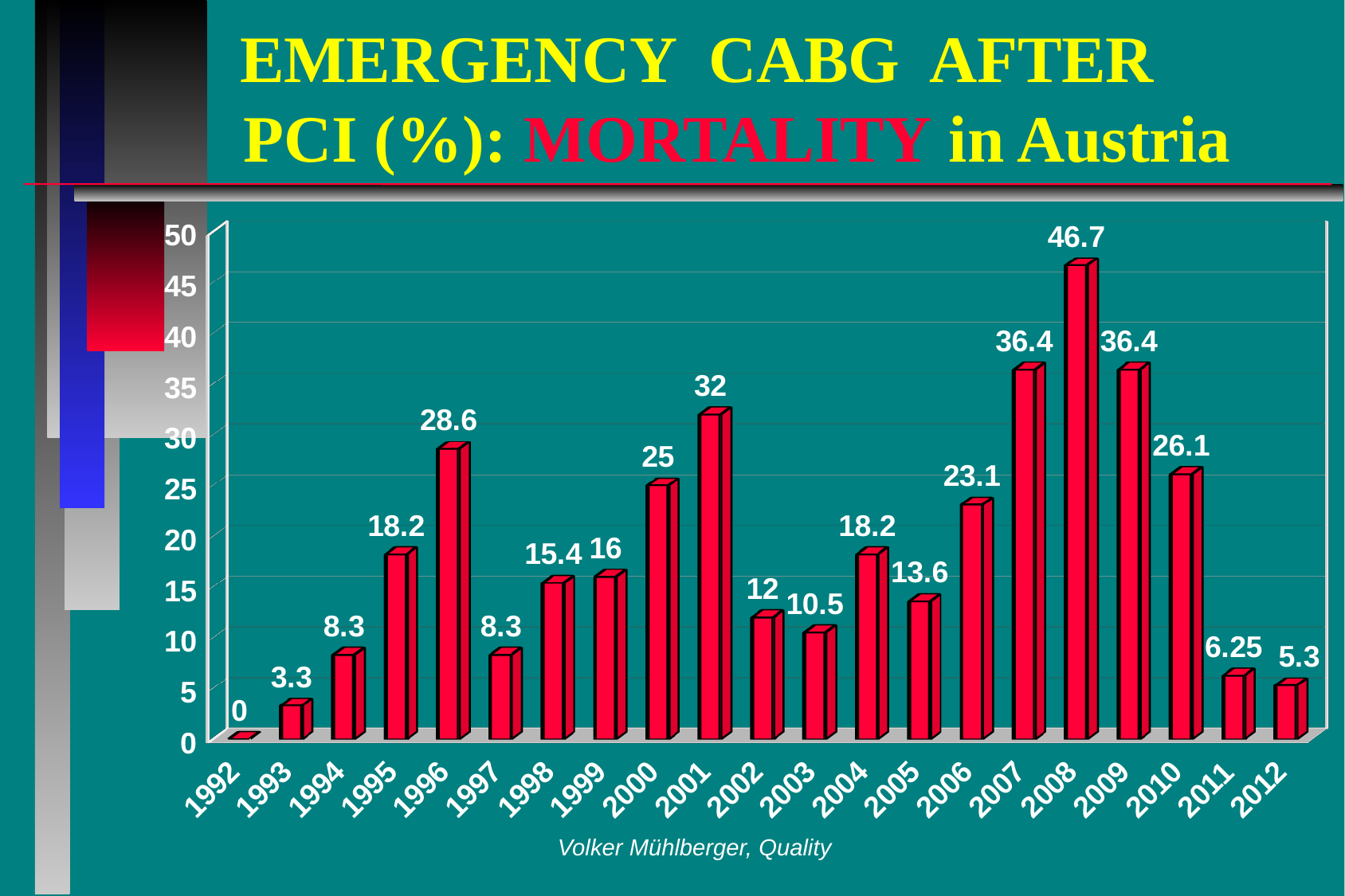
Do the values rise or fall from 2008 to 2012? fall Which is larger, the value for 1995 or the value for 2005? 1995 How many years are shown on the x axis? 21 What is the mortality value for 2011? 6.25 Which is larger, the value for 2000 or the value for 2010? 2010 Which year has the lowest mortality value? 1992 What is the mortality value for 2008? 46.7 Which year has the highest mortality value? 2008 What is the difference between the values for 2001 and 2002? 20 What kind of chart is shown on the slide? bar chart What is the mortality value for 1996? 28.6 What is the difference between the values for 2008 and 2009? 10.3